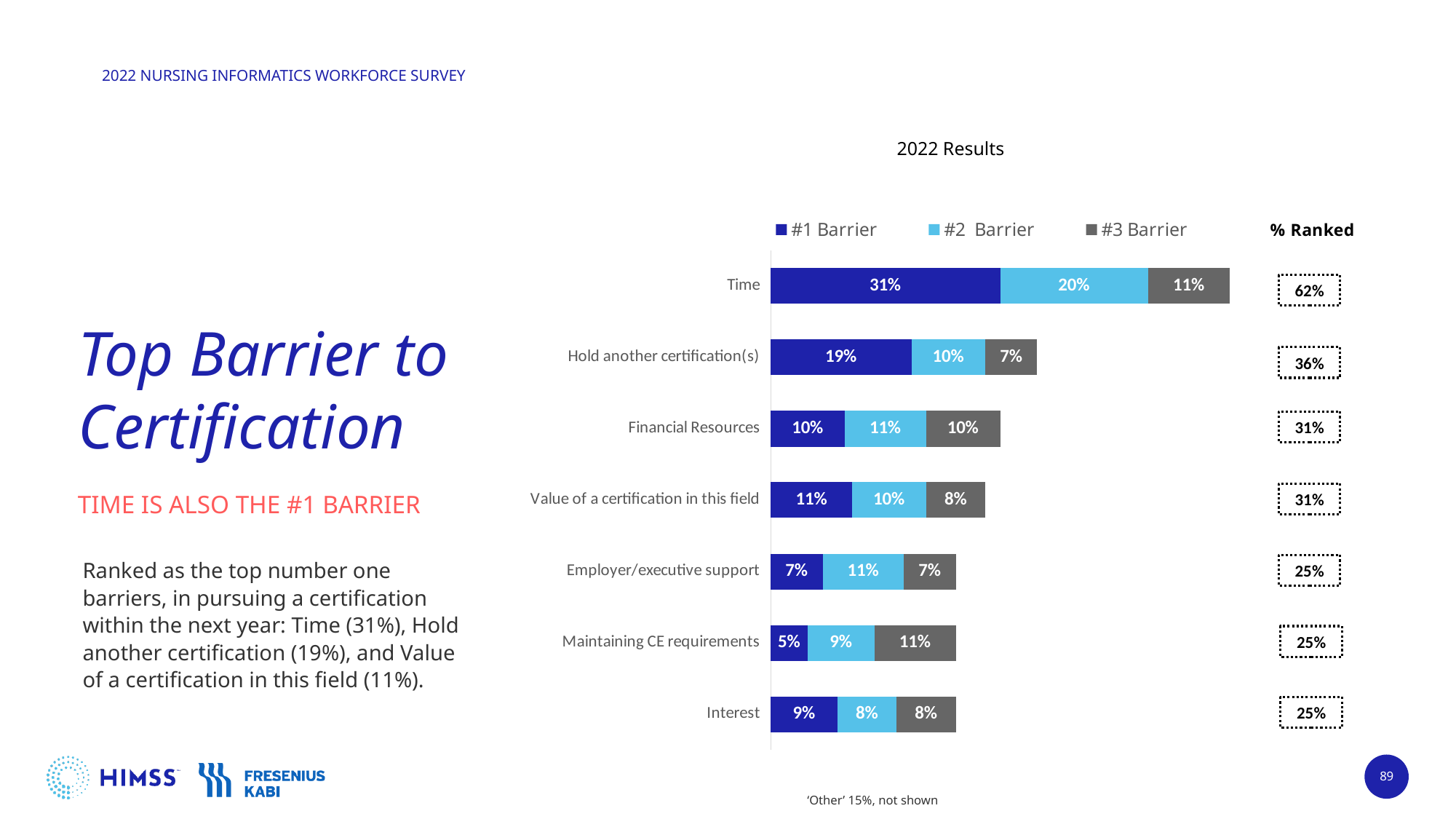
What is the #1 Barrier value for Time? 31% What is the #2 Barrier value for Hold another certification(s)? 10% Which category has the highest #1 Barrier value? Time What is the total of the stacked bar for Financial Resources? 31% How many categories are shown on the chart? 7 What kind of chart is shown on the slide? Stacked bar chart What is the difference between the #1 Barrier values for Time and Hold another certification(s)? 12% What is the #3 Barrier value for Maintaining CE requirements? 11% Which is larger: the #2 Barrier value for Time or the #2 Barrier value for Interest? Time Which category has the lowest #1 Barrier value? Maintaining CE requirements How many series does the legend list? 3 What is the title of the chart? 2022 Results